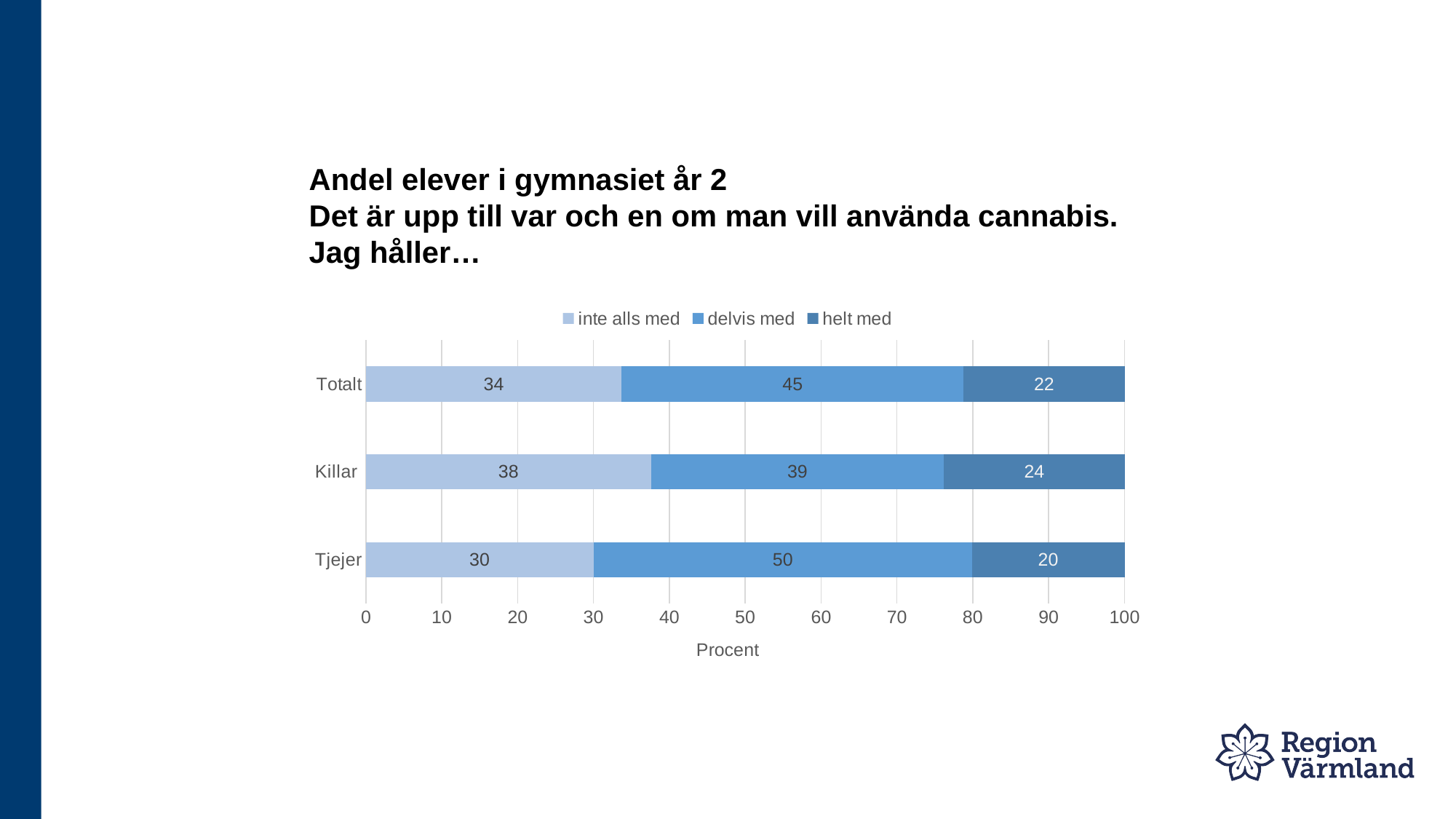
How many categories are shown on the y axis? 3 What is the total of the stacked bar for Killar? 101 What kind of chart is shown on the slide? Stacked bar chart What is the label of the x axis? Procent Which category has the highest value for "delvis med"? Tjejer Which is larger: "delvis med" for Killar or "delvis med" for Totalt? Totalt What is the value for "inte alls med" for Totalt? 34 Which category has the lowest value for "helt med"? Tjejer What is the difference between the "inte alls med" values for Killar and Tjejer? 8 What is the value for "helt med" for Killar? 24 How many series does the legend list? 3 What is the value for "delvis med" for Tjejer? 50